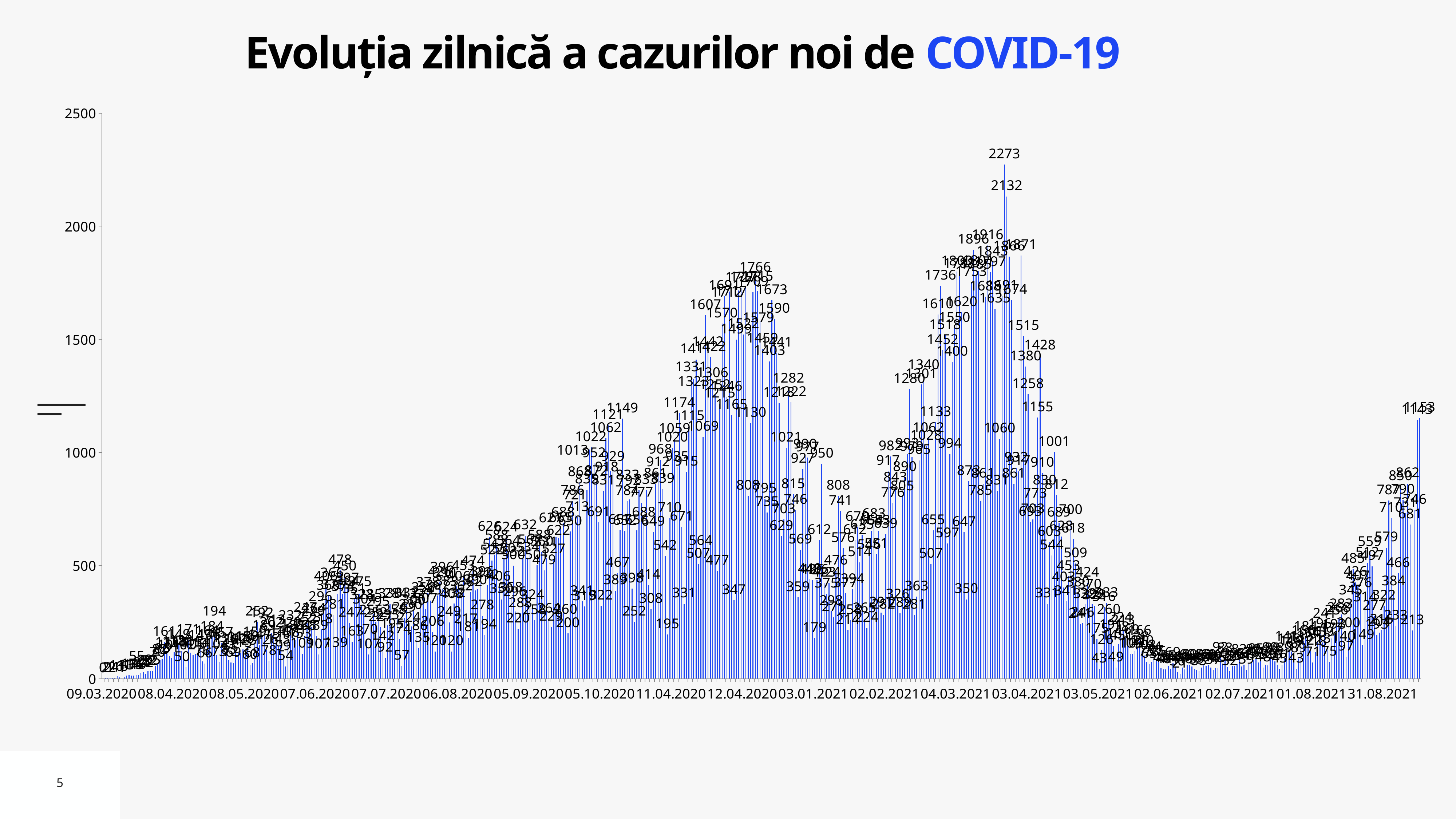
What is the title of the chart? Evoluția zilnică a cazurilor noi de COVID-19 What is the second-highest daily value labelled on the chart? 2132 Is the value at the first date on the x axis, 09.03.2020, greater or less than 500? less What is the highest daily value labelled on the chart? 2273 Is the tallest bar on the chart greater or less than 2000? greater What kind of chart is shown on the slide? bar chart Are the values around 02.06.2021 greater or less than 500? less Do the values rise or fall between 02.07.2021 and 31.08.2021? rise Which is taller: the highest bar between 04.03.2021 and 03.05.2021, or the highest bar between 11.04.2020 and 03.01.2021? the one between 04.03.2021 and 03.05.2021 What is the difference between the two highest labelled values, 2273 and 2132? 141 What is the maximum value shown on the y axis? 2500 Do the values rise or fall between 03.04.2021 and 02.06.2021? fall